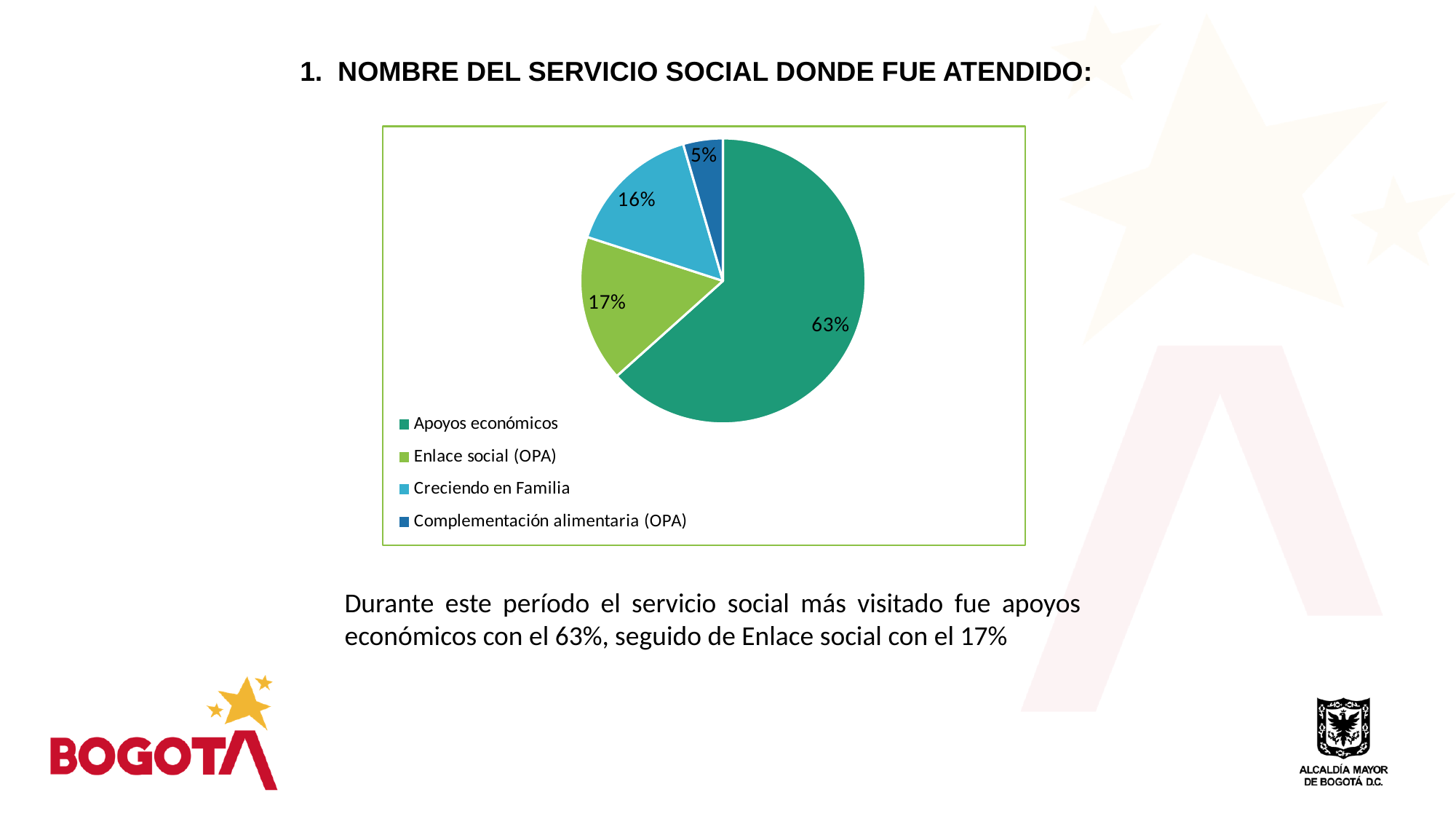
What share of the pie does Creciendo en Familia represent? 16% What is the difference in percentage points between Creciendo en Familia and Complementación alimentaria (OPA)? 11 What is the difference in percentage points between Apoyos económicos and Enlace social (OPA)? 46 Which category has the largest slice of the pie? Apoyos económicos Which is larger, the slice for Apoyos económicos or the slice for Creciendo en Familia? Apoyos económicos What share of the pie does Apoyos económicos represent? 63% What share of the pie does Complementación alimentaria (OPA) represent? 5% Which category has the smallest slice of the pie? Complementación alimentaria (OPA) What colour is the slice for Enlace social (OPA)? Green How many categories does the pie chart show? 4 What kind of chart is shown on the slide? Pie chart